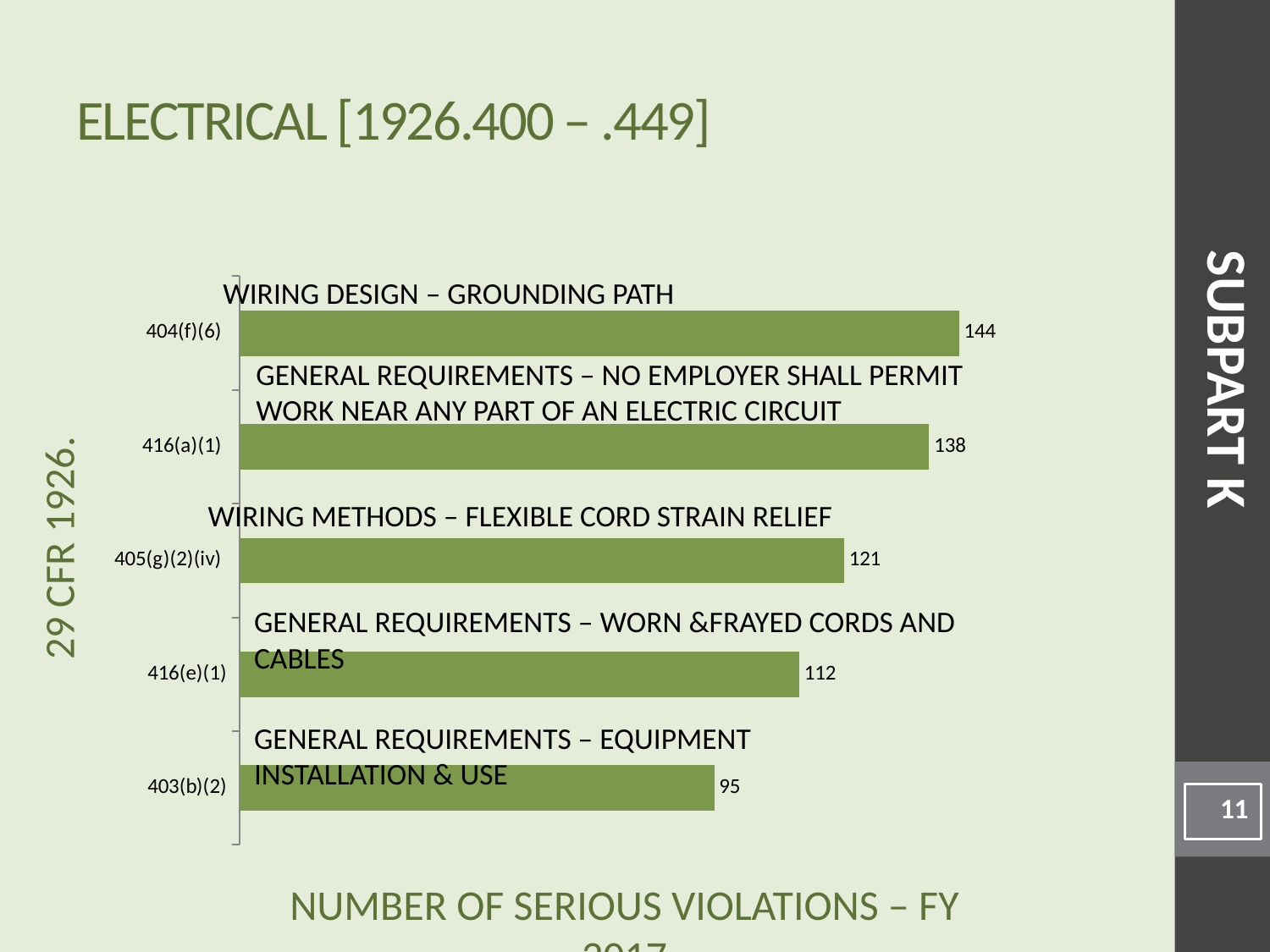
What is the difference between the values for 404(f)(6) and 403(b)(2)? 49 How many standards (categories) are shown in the chart? 5 Which has more serious violations, 405(g)(2)(iv) or 416(e)(1)? 405(g)(2)(iv) What is the difference between the values for 416(a)(1) and 416(e)(1)? 26 Which standard has the lowest number of serious violations? 403(b)(2) Which standard has the highest number of serious violations? 404(f)(6) What is the number of serious violations for 416(a)(1)? 138 What kind of chart is shown on the slide? Bar chart What is the number of serious violations for 403(b)(2)? 95 What is the number of serious violations for 405(g)(2)(iv)? 121 What is the label shown below the chart? NUMBER OF SERIOUS VIOLATIONS – FY What is the number of serious violations for 404(f)(6)? 144